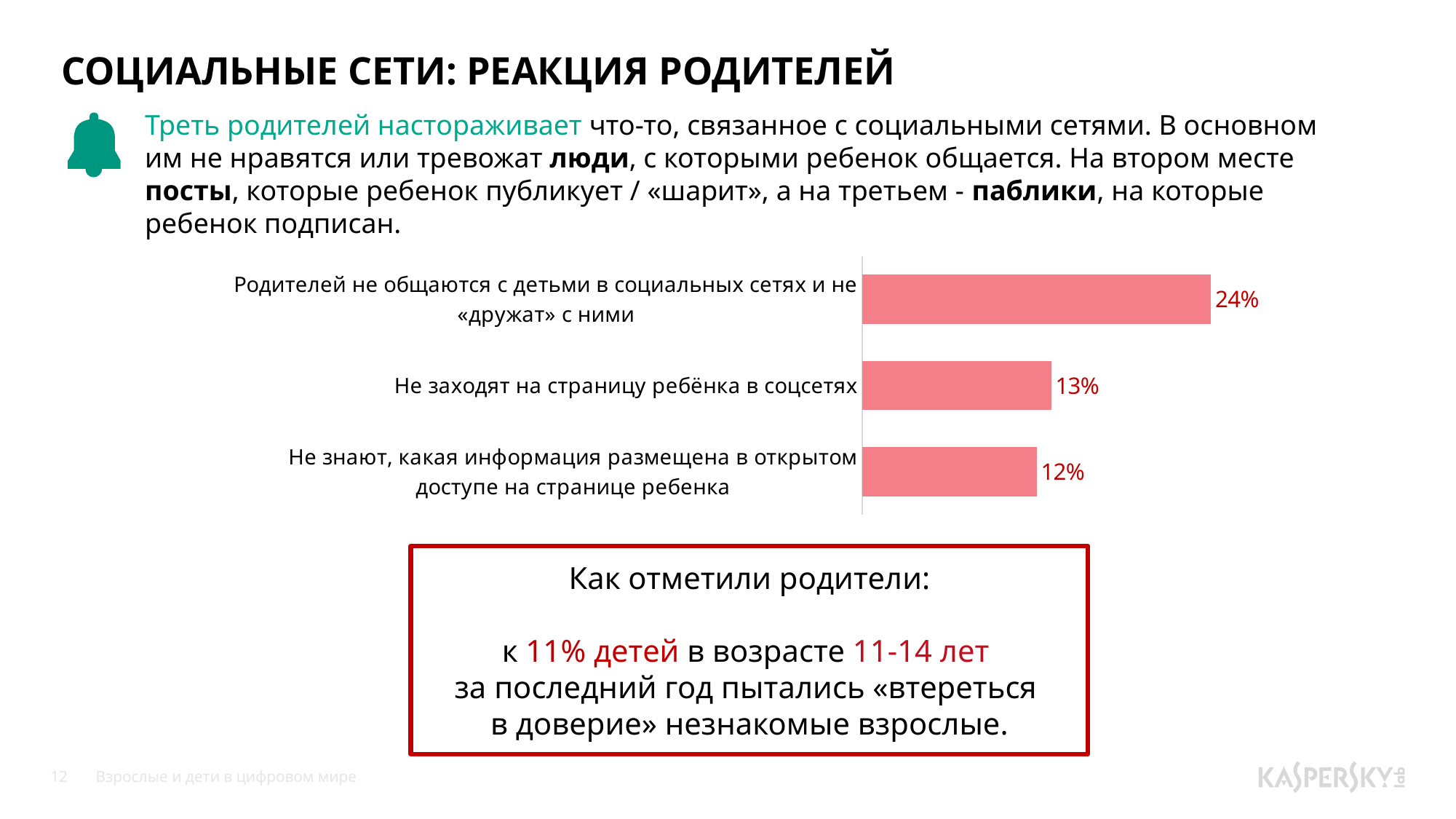
What type of chart is shown on the slide? Bar chart How many categories are shown in the chart? 3 What is the value for 'Не заходят на страницу ребёнка в соцсетях'? 13% What is the difference between the value for parents who do not communicate with children on social networks (24%) and those who do not visit the child's page (13%)? 11% Are the bars in the chart oriented horizontally or vertically? Horizontally Which category has the highest value in the chart? Родителей не общаются с детьми в социальных сетях и не «дружат» с ними What is the difference between the values for 'Не заходят на страницу ребёнка в соцсетях' and 'Не знают, какая информация размещена в открытом доступе на странице ребенка'? 1% What percentage of parents do not know what information is publicly available on their child's page? 12% Which is larger: the value for parents who do not communicate with children on social networks, or the value for parents who do not visit the child's page? Родителей не общаются с детьми в социальных сетях и не «дружат» с ними What colour are the bars in the chart? Pink/red Which category has the lowest value in the chart? Не знают, какая информация размещена в открытом доступе на странице ребенка What percentage of parents do not communicate with their children on social networks and are not 'friends' with them? 24%